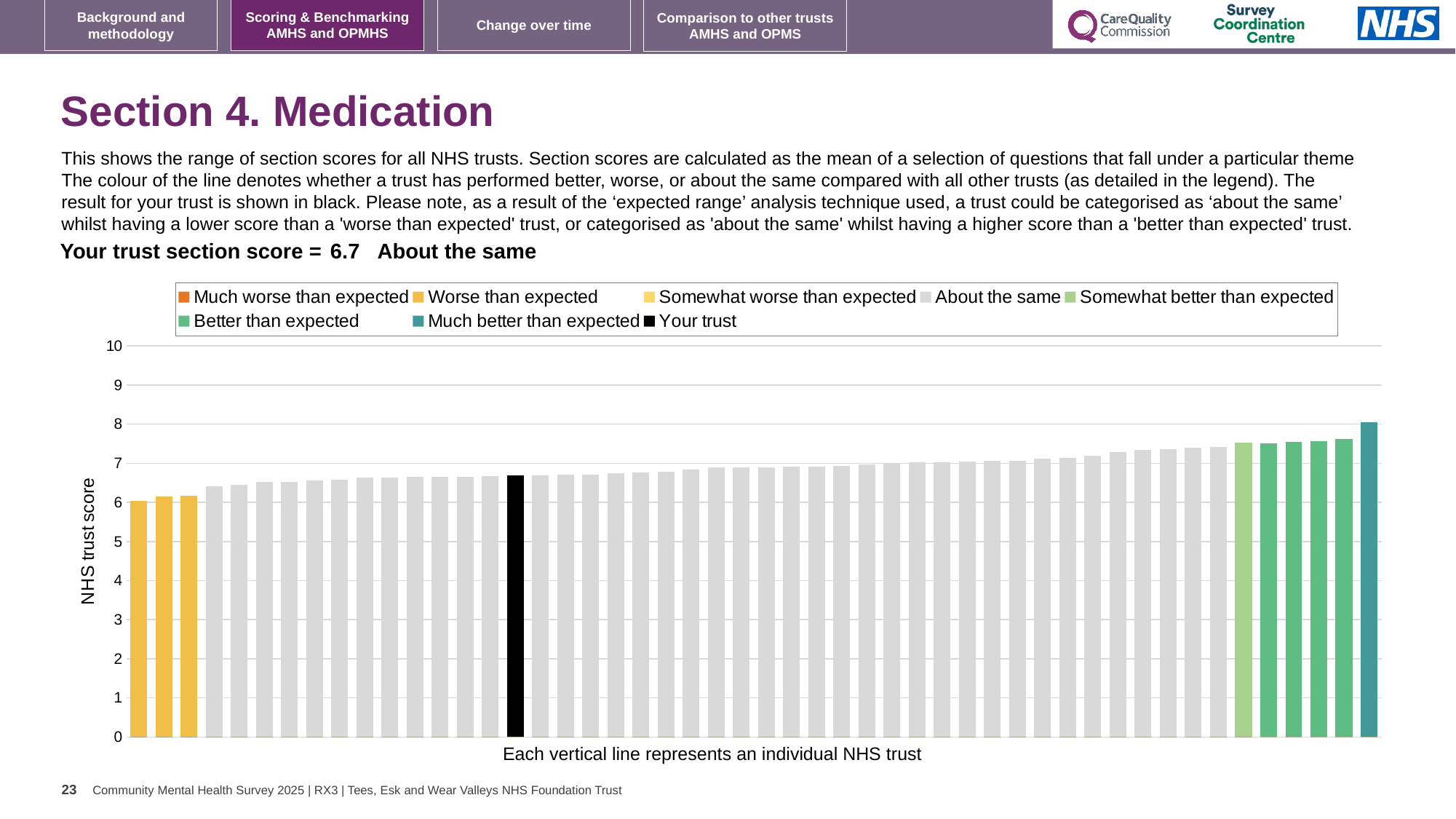
Is the value of the tallest bar greater or less than 7? greater Which legend category does the shortest bar belong to? Worse than expected How many bars are coloured as 'Worse than expected'? 3 Is the value of the shortest bar greater or less than 7? less Which performance category does your trust fall into for this section? About the same Which legend category does the tallest bar belong to? Much better than expected What is your trust's section score for Medication? 6.7 Do the bar values rise or fall from left to right along the x axis? rise What kind of chart is shown on the slide? Bar chart What is the label on the vertical axis of the chart? NHS trust score Is the value of the black 'Your trust' bar greater or less than 5? greater How many entries does the chart legend list? 8